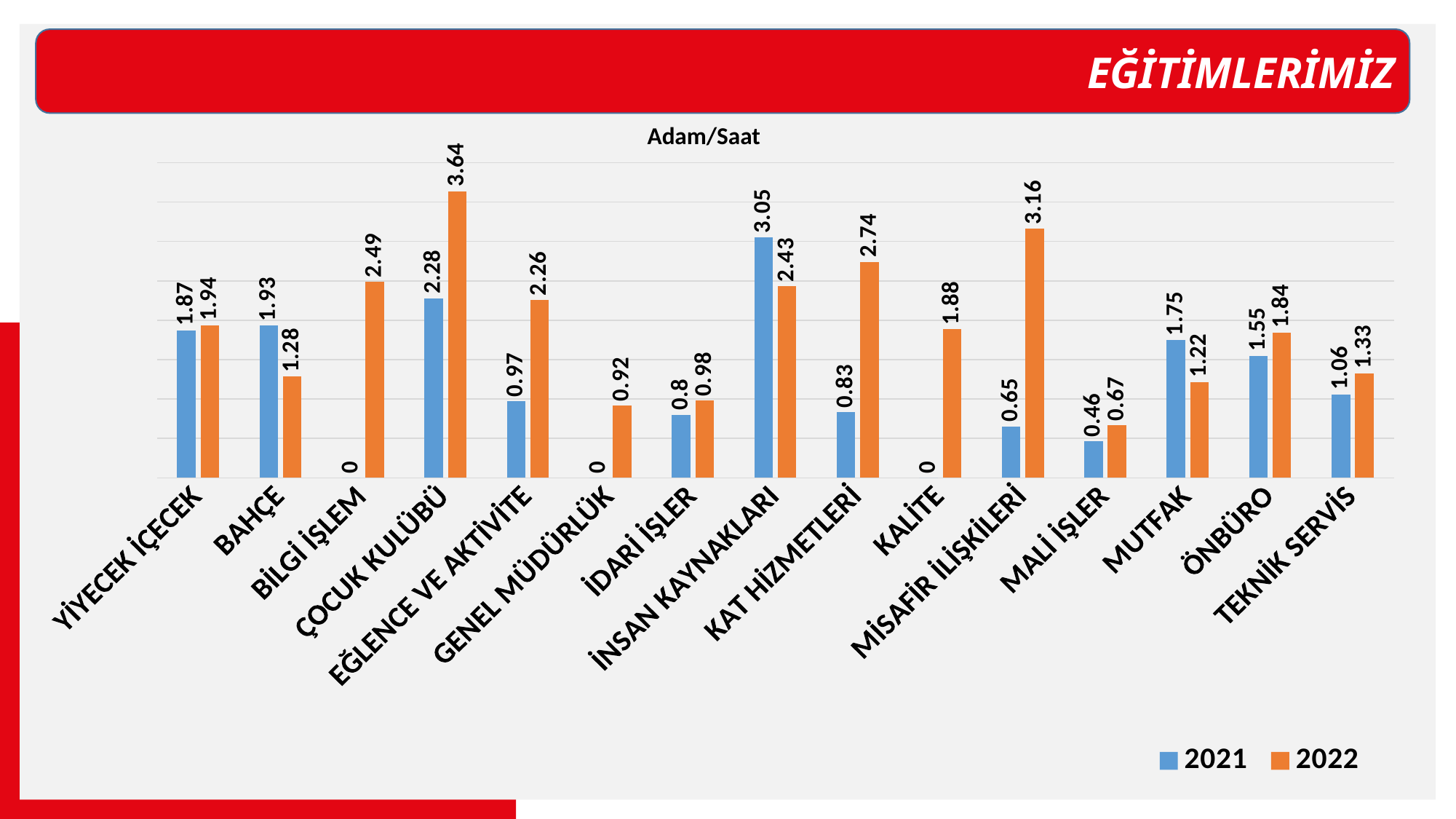
Which category has the lowest 2022 value? MALİ İŞLER For BAHÇE, which year has the larger value, 2021 or 2022? 2021 What is the 2022 value for ÇOCUK KULÜBÜ? 3.64 How many series does the legend list? 2 What is the difference between the 2021 and 2022 values for BAHÇE? 0.65 What is the difference between the 2022 and 2021 values for ÇOCUK KULÜBÜ? 1.36 What is the 2021 value for BİLGİ İŞLEM? 0 What is the 2021 value for İNSAN KAYNAKLARI? 3.05 Which category has the highest 2022 value? ÇOCUK KULÜBÜ How many categories are shown on the x axis? 15 What type of chart is shown on the slide? bar chart What is the chart's title? Adam/Saat